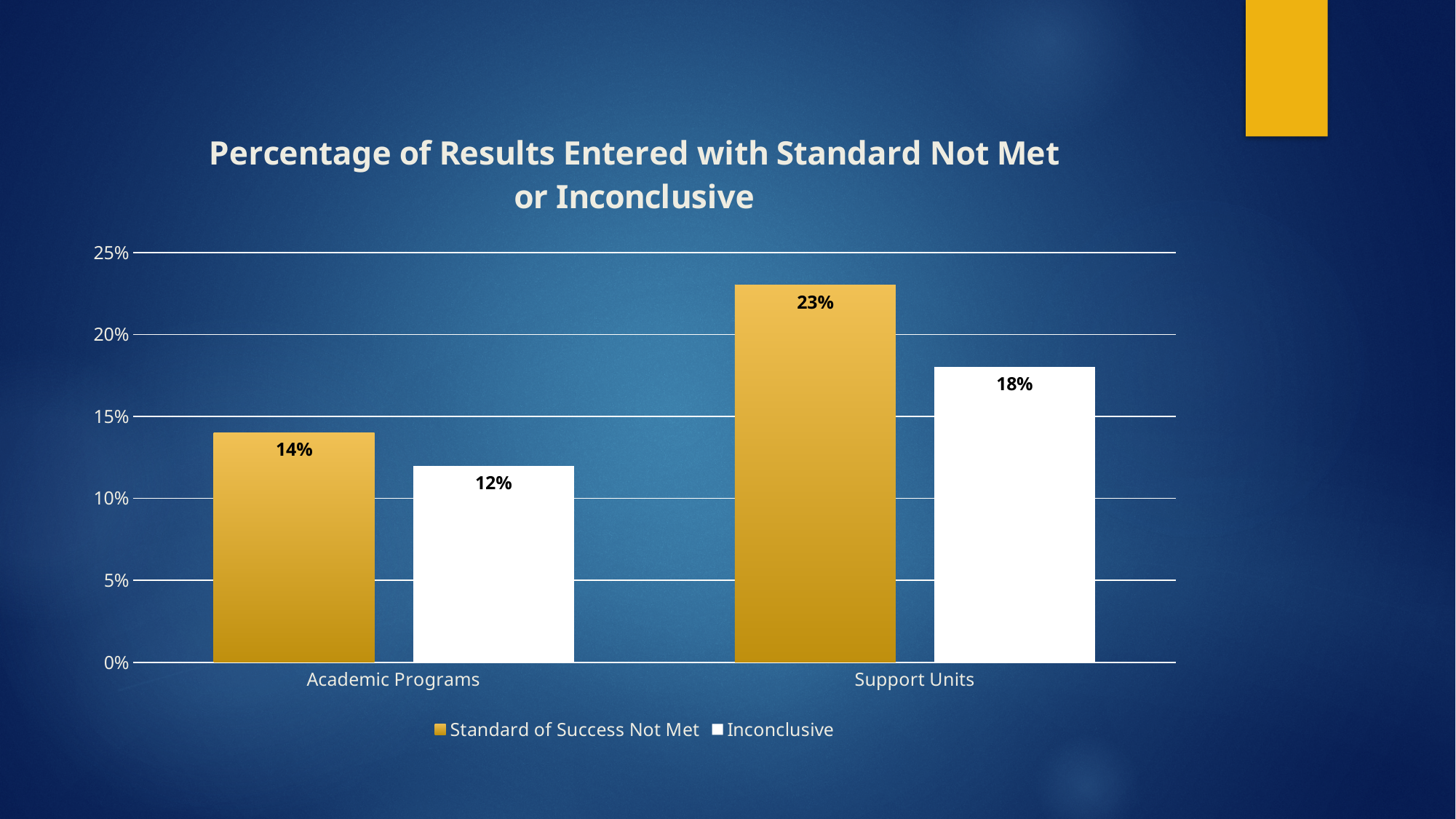
How many series does the legend list? 2 Which is larger for Academic Programs: Standard of Success Not Met or Inconclusive? Standard of Success Not Met Which category has the highest Standard of Success Not Met value? Support Units What is the value for Inconclusive for Support Units? 18% Is the Standard of Success Not Met value for Support Units greater or less than 20%? greater How many categories are shown on the x axis? 2 What is the value for Standard of Success Not Met for Academic Programs? 14% What is the difference between the Standard of Success Not Met and Inconclusive values for Support Units? 5% What is the difference between the Standard of Success Not Met values for Support Units and Academic Programs? 9% What kind of chart is shown on the slide? Bar chart Which category has the lowest Inconclusive value? Academic Programs What is the value for Inconclusive for Academic Programs? 12%